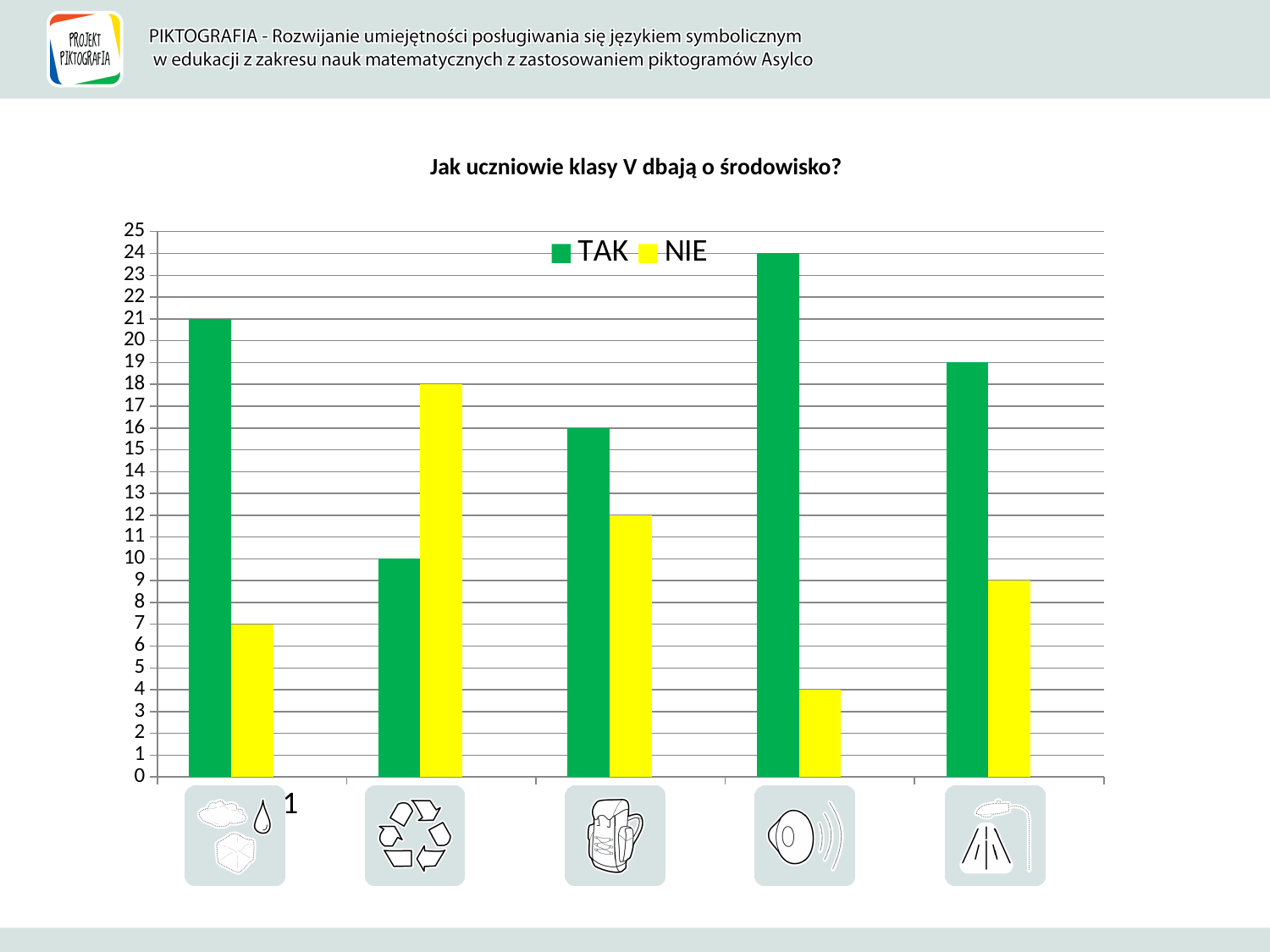
Which group has the lowest NIE value? the fourth group from the left (speaker pictogram) What is the title of the chart? Jak uczniowie klasy V dbają o środowisko? How many series does the legend list? 2 Is the TAK value for the fifth group from the left (shower pictogram) greater or less than 15? greater What is the NIE value for the second group from the left (recycling pictogram)? 18 What is the TAK value for the first group from the left (the one marked with 1)? 21 Which group has the highest TAK value? the fourth group from the left (speaker pictogram) What kind of chart is shown on the slide? bar chart How many category groups (pictograms) are shown along the x axis? 5 In the third group from the left (backpack pictogram), which is larger, TAK or NIE? TAK What are the two series named in the legend? TAK and NIE What is the difference between the TAK and NIE values in the fourth group from the left (speaker pictogram)? 20